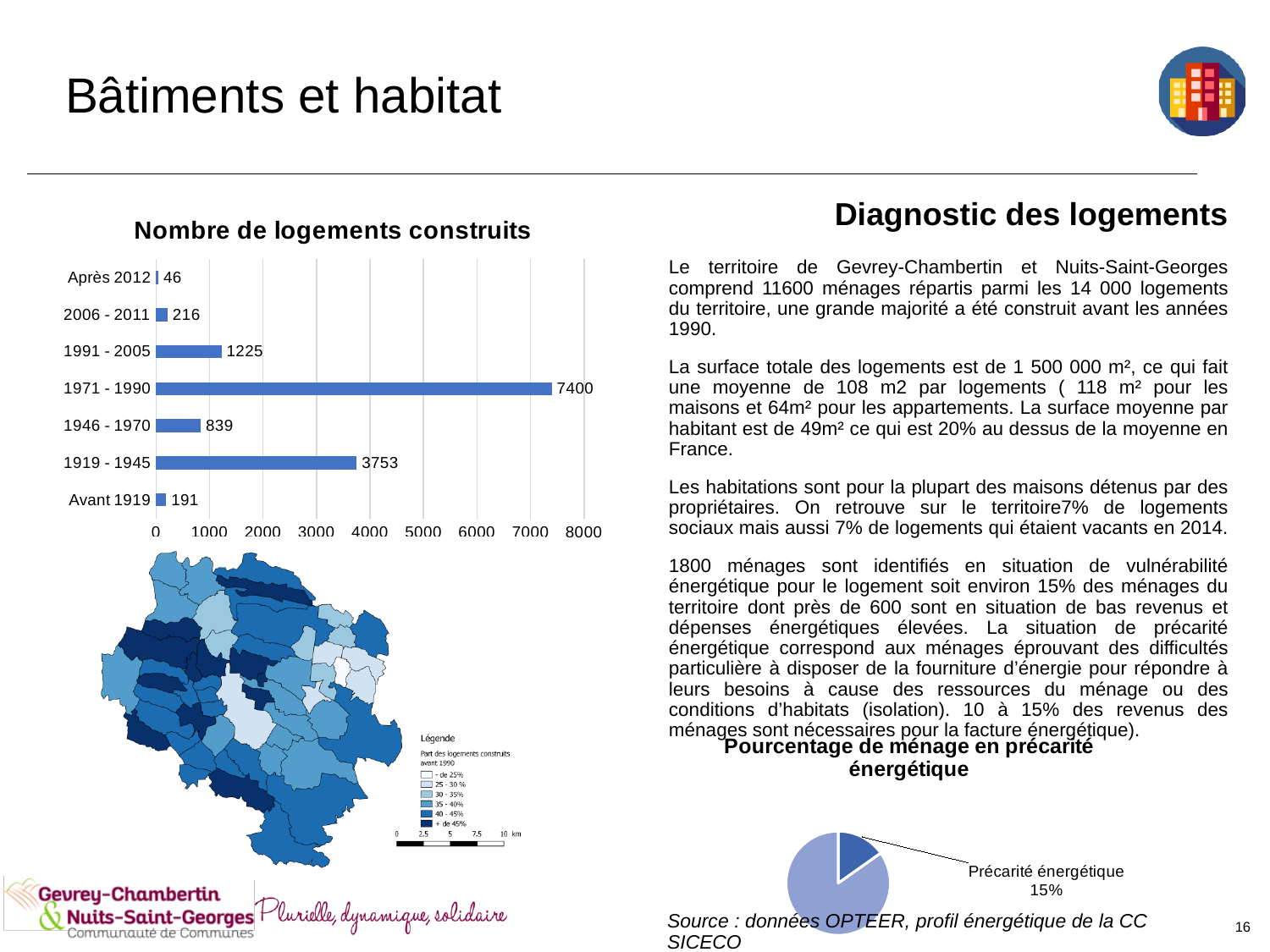
What kind of chart is 'Nombre de logements construits'? bar chart How many periods (categories) are shown in the chart 'Nombre de logements construits'? 7 In the chart 'Nombre de logements construits', which period has the highest number of housing units built? 1971 - 1990 In the chart 'Nombre de logements construits', what is the value for 1919 - 1945? 3753 In the pie chart 'Pourcentage de ménage en précarité énergétique', what share of households is in energy precarity (Précarité énergétique)? 15% In the chart 'Nombre de logements construits', what is the difference between the values for 1971 - 1990 and 1919 - 1945? 3647 In the chart 'Nombre de logements construits', which is larger: the value for 1946 - 1970 or the value for 1991 - 2005? 1991 - 2005 In the chart 'Nombre de logements construits', what is the value for Après 2012? 46 What kind of chart is 'Pourcentage de ménage en précarité énergétique'? pie chart In the chart 'Nombre de logements construits', which period has the lowest number of housing units built? Après 2012 In the chart 'Nombre de logements construits', how many housing units were built in the period 1971 - 1990? 7400 In the chart 'Nombre de logements construits', is the value for 1991 - 2005 greater or less than 1000? greater